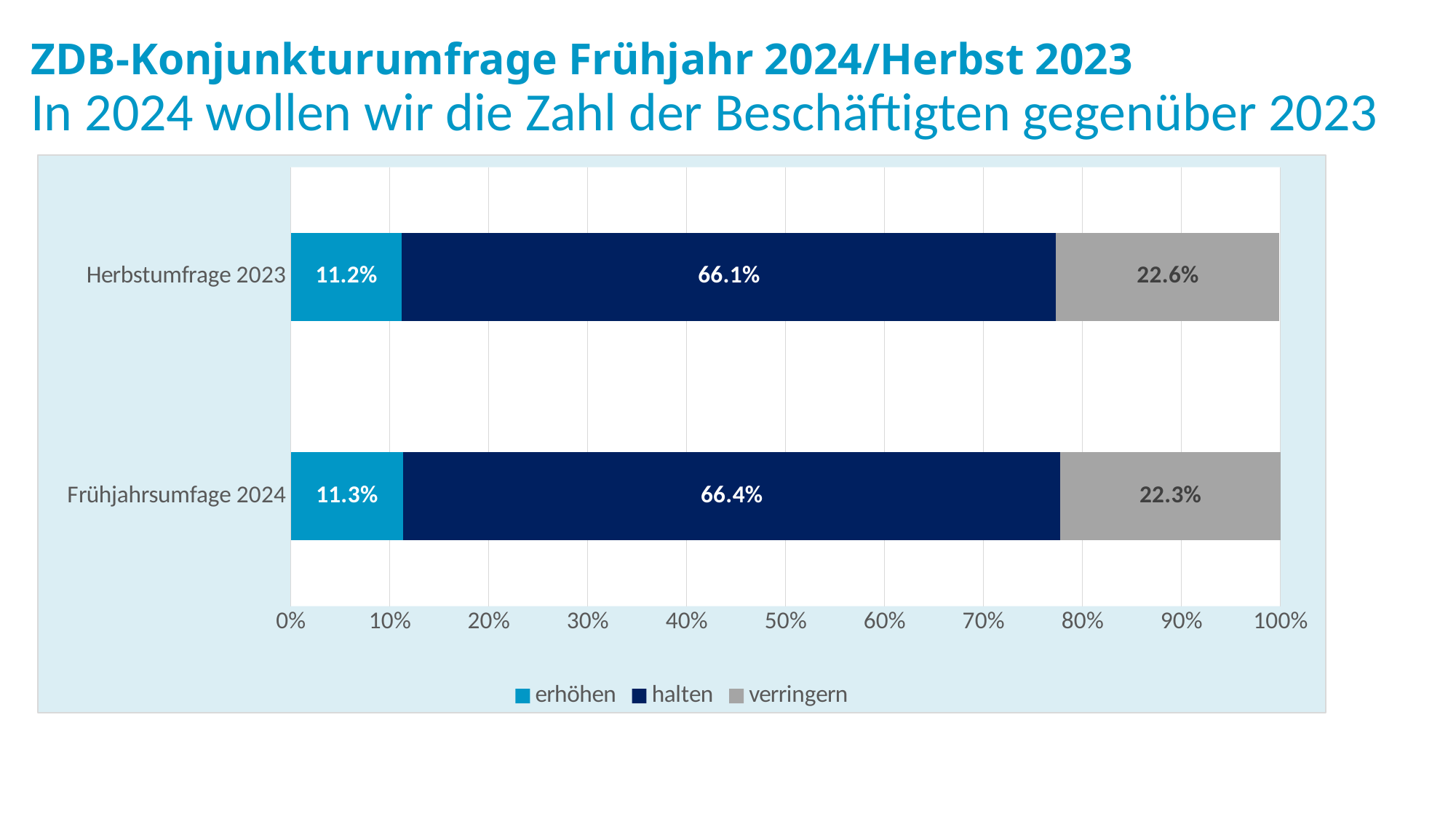
What is the difference between the "verringern" values for Herbstumfrage 2023 and Frühjahrsumfage 2024? 0.3% What is the total of the Frühjahrsumfage 2024 stacked bar? 100% Which legend entry is shown in grey? verringern What is the value for "verringern" in the Herbstumfrage 2023 bar? 22.6% How many categories (bars) are shown in the chart? 2 What is the value for "erhöhen" in the Frühjahrsumfage 2024 bar? 11.3% What is the value for "halten" in the Herbstumfrage 2023 bar? 66.1% What kind of chart is shown on the slide? stacked bar chart Which series has the largest share in the Frühjahrsumfage 2024 bar? halten What is the value for "verringern" in the Frühjahrsumfage 2024 bar? 22.3% Which series has the smallest share in the Herbstumfrage 2023 bar? erhöhen How many series does the legend list? 3